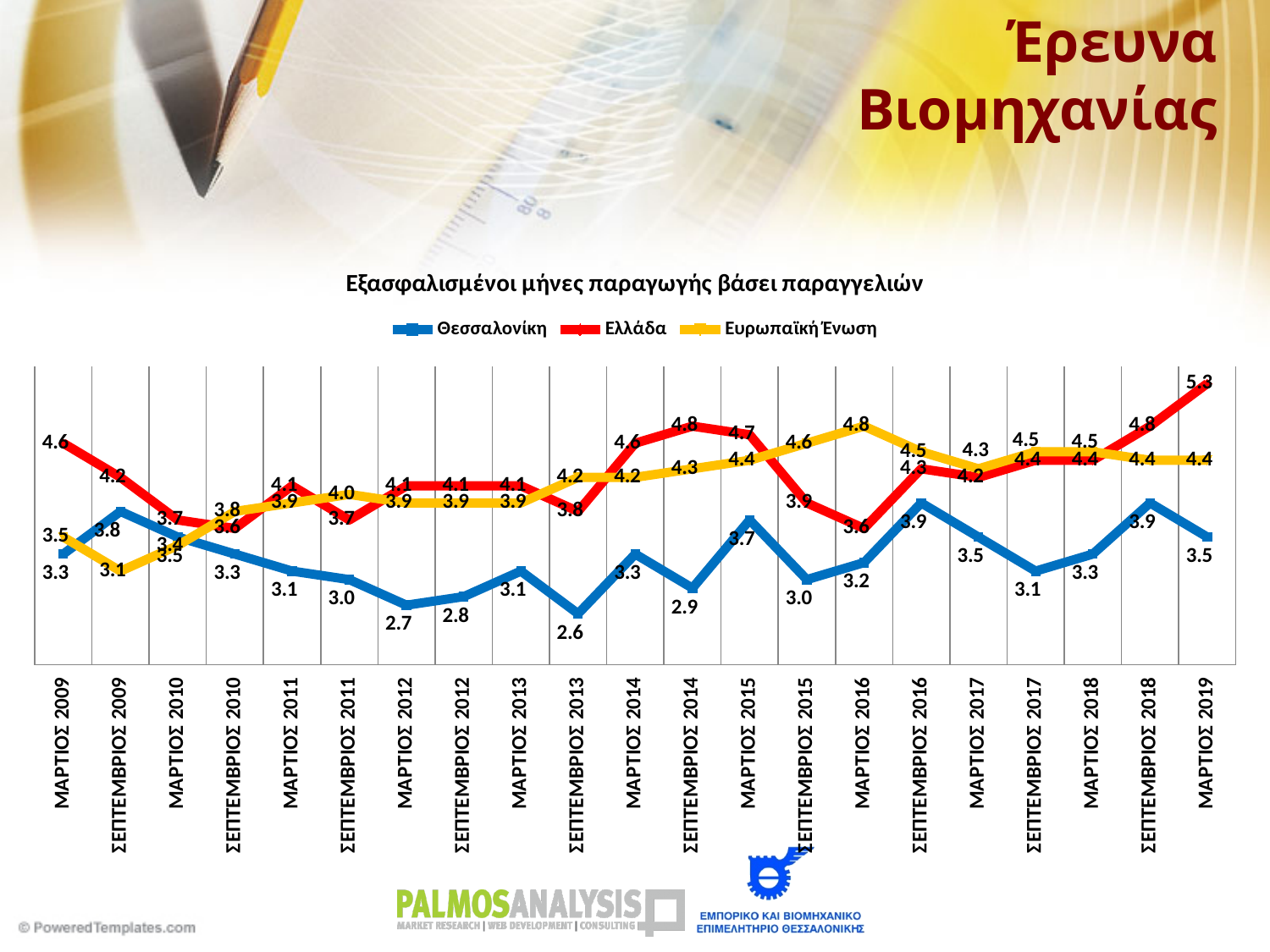
What is the difference between Ελλάδα and Θεσσαλονίκη in ΜΑΡΤΙΟΣ 2019? 1.8 At which time point does Θεσσαλονίκη reach its lowest value? ΣΕΠΤΕΜΒΡΙΟΣ 2013 How many series does the legend list? 3 What kind of chart is shown on the slide? line chart What is the value for Θεσσαλονίκη in ΣΕΠΤΕΜΒΡΙΟΣ 2013? 2.6 What is the value for Ευρωπαϊκή Ένωση in ΜΑΡΤΙΟΣ 2016? 4.8 What is the value for Θεσσαλονίκη in ΜΑΡΤΙΟΣ 2012? 2.7 At which time point does Ελλάδα reach its highest value? ΜΑΡΤΙΟΣ 2019 In ΜΑΡΤΙΟΣ 2016, which is larger: Ευρωπαϊκή Ένωση or Ελλάδα? Ευρωπαϊκή Ένωση What is the title of the chart? Εξασφαλισμένοι μήνες παραγωγής βάσει παραγγελιών How many time points are plotted along the x axis? 21 What is the value for Ελλάδα in ΜΑΡΤΙΟΣ 2019? 5.3